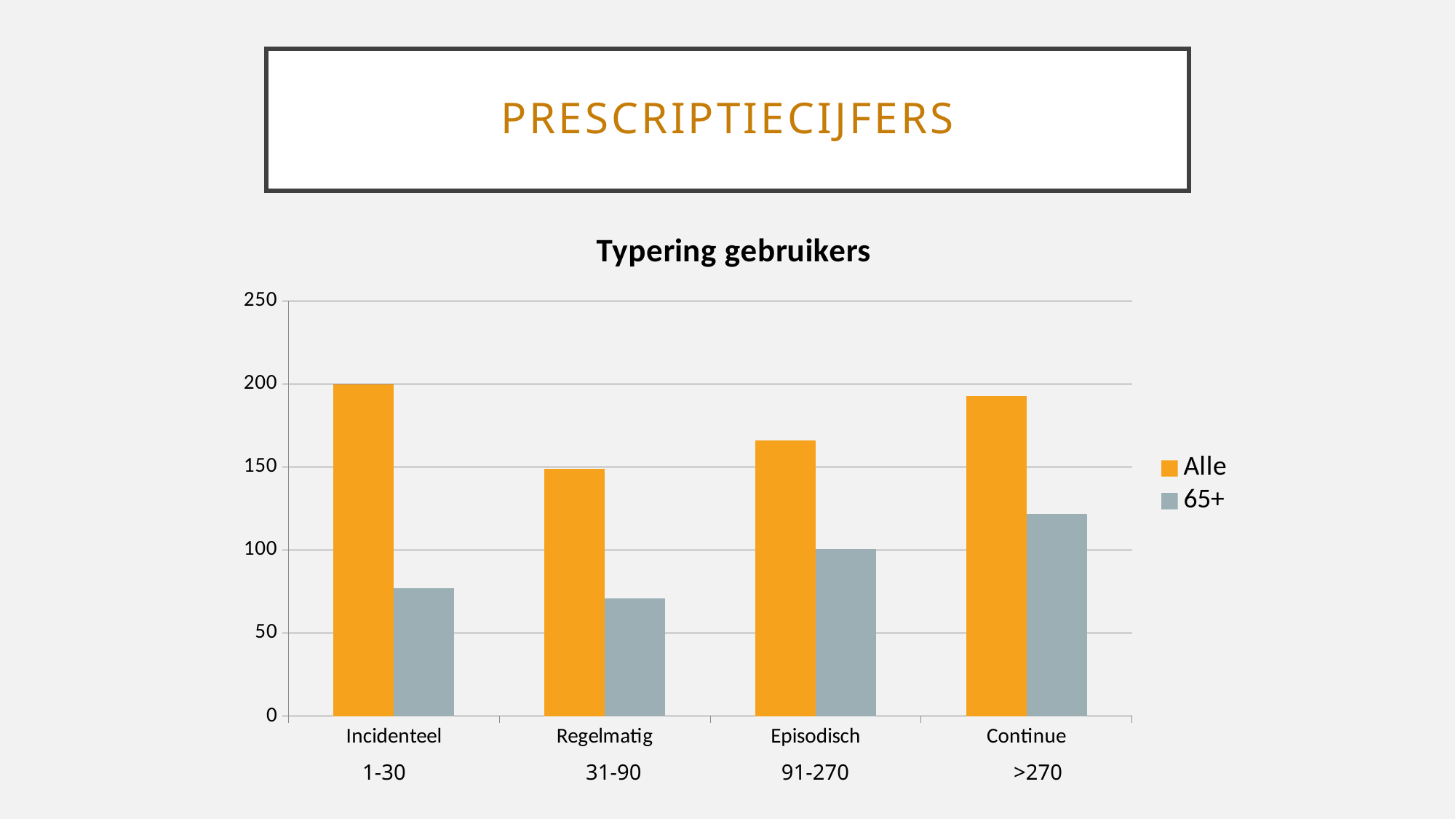
Is the value for '65+' in the Incidenteel category greater or less than 100? less Which category has the highest value for the '65+' series? Continue Is the value for 'Alle' in the Continue category greater or less than 200? less Which is larger for the '65+' series: Incidenteel or Episodisch? Episodisch Is the value for 'Alle' in the Episodisch category greater or less than 150? greater Which colour represents the 'Alle' series in the legend? orange What type of chart is shown under the title 'Typering gebruikers'? bar chart How many series does the legend of the 'Typering gebruikers' chart list? 2 How many categories are shown on the x axis of the 'Typering gebruikers' chart? 4 Which category has the lowest value for the 'Alle' series? Regelmatig Which is larger for the 'Alle' series: Episodisch or Continue? Continue